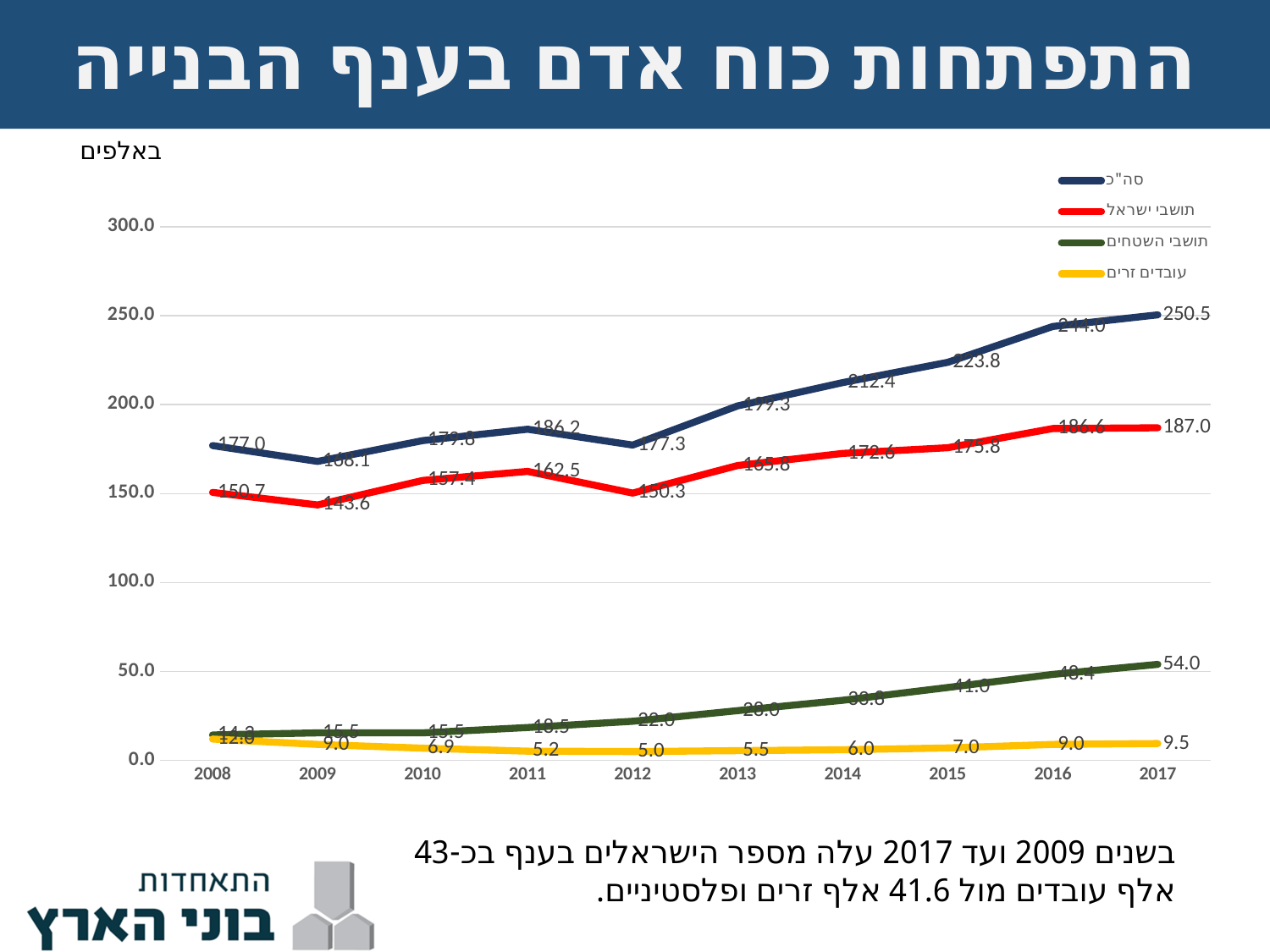
What is the value of the תושבי ישראל series in 2017? 187.0 How many series does the legend list? 4 What type of chart is shown on the slide? line chart Does the תושבי השטחים series rise or fall from 2012 to 2017? rise What is the difference between the סה"כ value in 2017 (250.5) and in 2008 (177.0)? 73.5 How many years are shown on the x axis? 10 What is the value of the תושבי השטחים series in 2017? 54.0 In which year is the סה"כ (total) series at its highest? 2017 What is the value of the עובדים זרים series in 2012? 5.0 In which year is the עובדים זרים series at its lowest? 2012 Which is larger in 2017: the תושבי השטחים value or the עובדים זרים value? תושבי השטחים What is the value of the סה"כ (total) series in 2017? 250.5